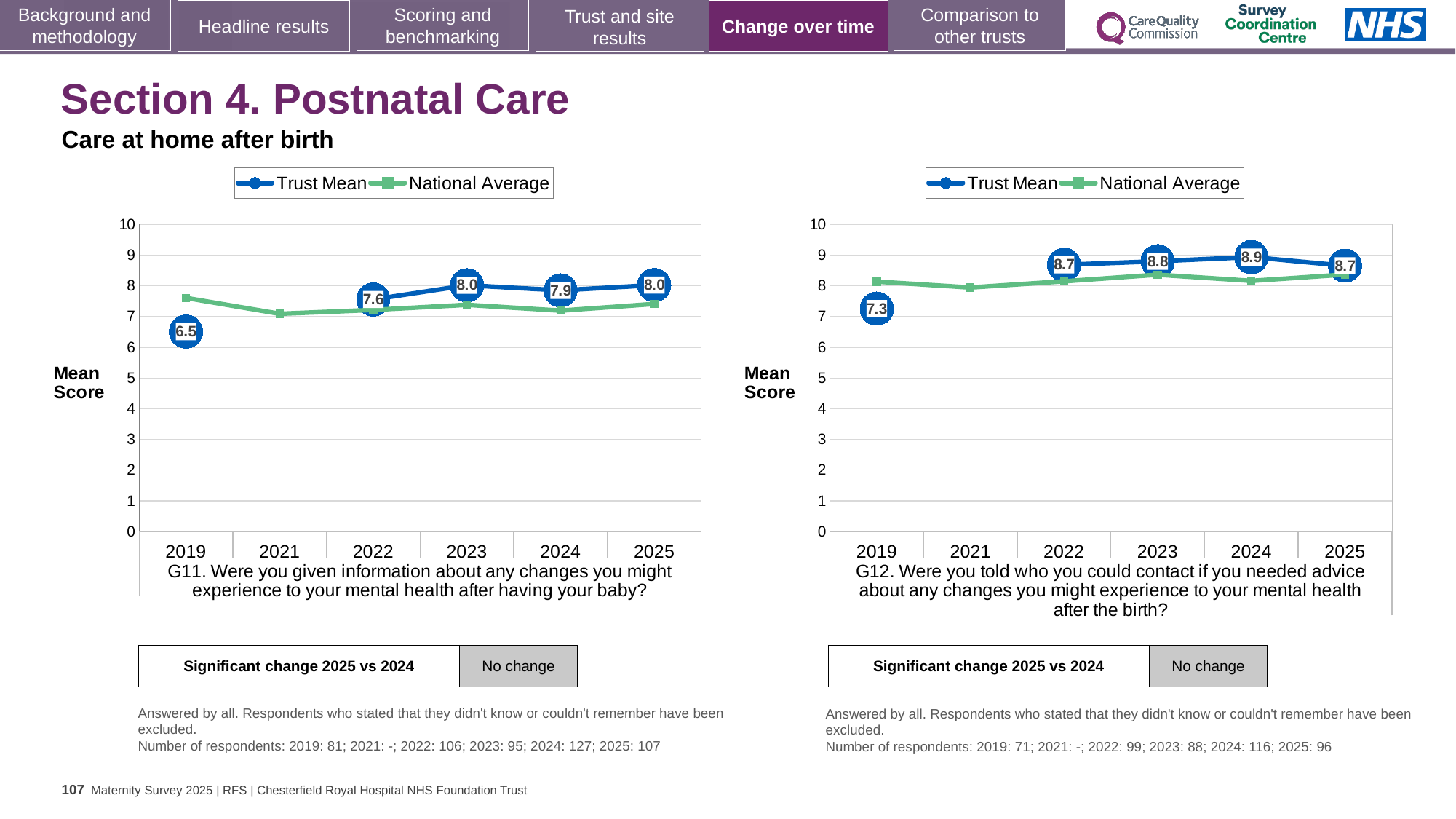
How many years are shown on the x axis of the G12 chart on the right? 6 In the G11 chart on the left, what is the difference between the Trust Mean scores for 2025 and 2019? 1.5 What type of chart is the G12 chart on the right? Line chart In the G11 chart on the left, is the Trust Mean score higher in 2023 or 2024? 2023 In the G11 chart on the left, what is the Trust Mean score for 2019? 6.5 In the G11 chart on the left, which year has the lowest Trust Mean score? 2019 In the G12 chart on the right, what is the difference between the Trust Mean scores for 2024 and 2019? 1.6 In the G12 chart on the right, is the National Average value for 2023 greater or less than 8? greater In the G12 chart on the right, what is the Trust Mean score for 2024? 8.9 How many series does the legend of the G11 chart on the left list? 2 In the G11 chart on the left, is the National Average value for 2021 greater or less than 8? less In the G12 chart on the right, which year has the highest Trust Mean score? 2024